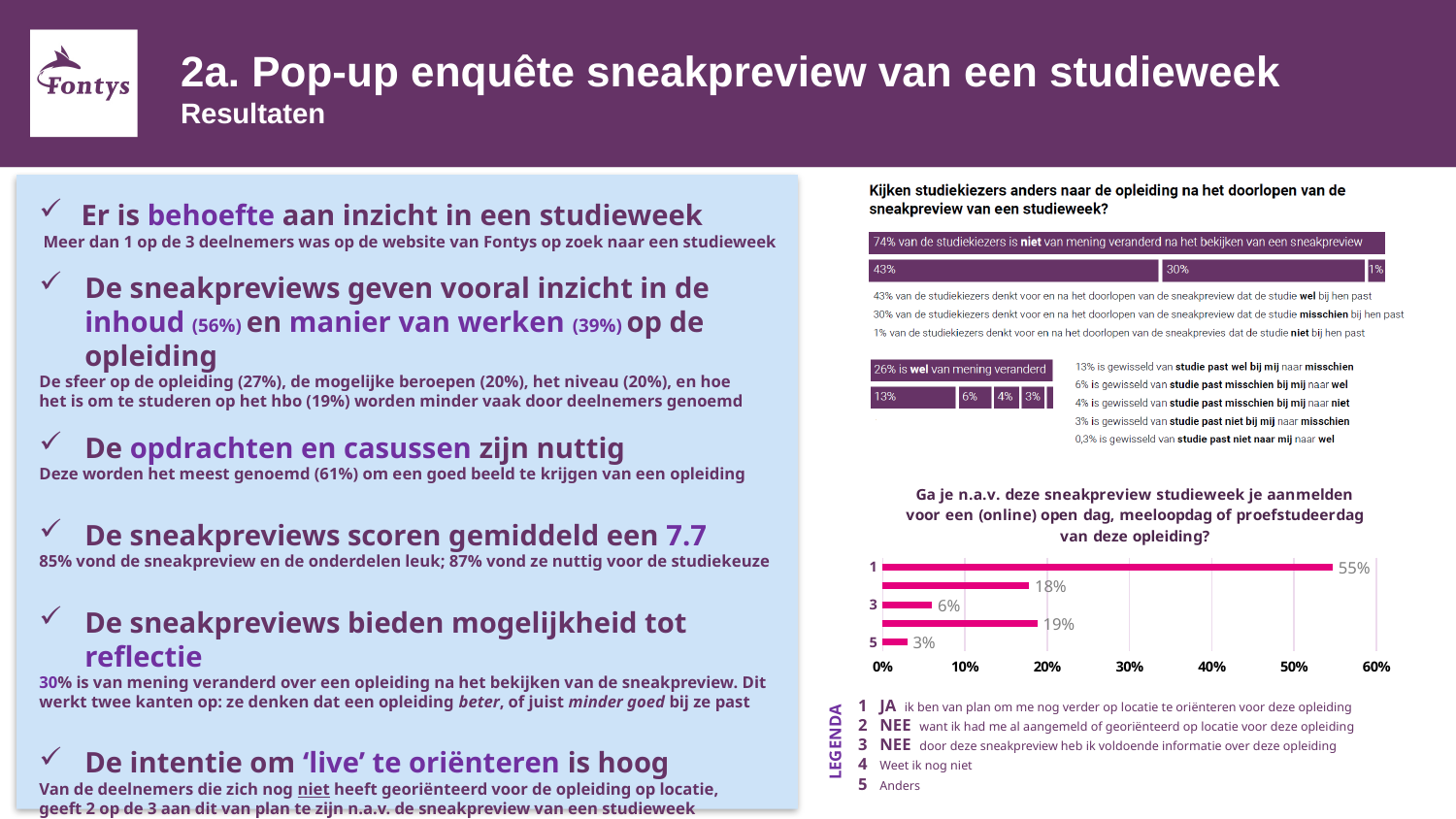
In the chart 'Ga je n.a.v. deze sneakpreview studieweek je aanmelden...', how many categories are shown? 5 In the chart 'Ga je n.a.v. deze sneakpreview studieweek je aanmelden...', what is the difference between the values for category 1 and category 2? 37% In the chart 'Ga je n.a.v. deze sneakpreview studieweek je aanmelden...', what is the value for category 1? 55% In the chart 'Ga je n.a.v. deze sneakpreview studieweek je aanmelden...', which category has the highest value? 1 In the chart 'Ga je n.a.v. deze sneakpreview studieweek je aanmelden...', which is larger, the value for category 2 or category 4? Category 4 In the chart 'Ga je n.a.v. deze sneakpreview studieweek je aanmelden...', which category has the lowest value? 5 In the chart 'Ga je n.a.v. deze sneakpreview studieweek je aanmelden...', what is the highest value shown on the x axis? 60% What kind of chart is 'Ga je n.a.v. deze sneakpreview studieweek je aanmelden...'? Bar chart In the stacked bar '74% van de studiekiezers is niet van mening veranderd', what is the value of the largest segment? 43% In the chart 'Ga je n.a.v. deze sneakpreview studieweek je aanmelden...', what does legend entry 4 stand for? Weet ik nog niet In the chart 'Ga je n.a.v. deze sneakpreview studieweek je aanmelden...', what is the value for category 4? 19% In the chart 'Ga je n.a.v. deze sneakpreview studieweek je aanmelden...', what is the value for category 5? 3%